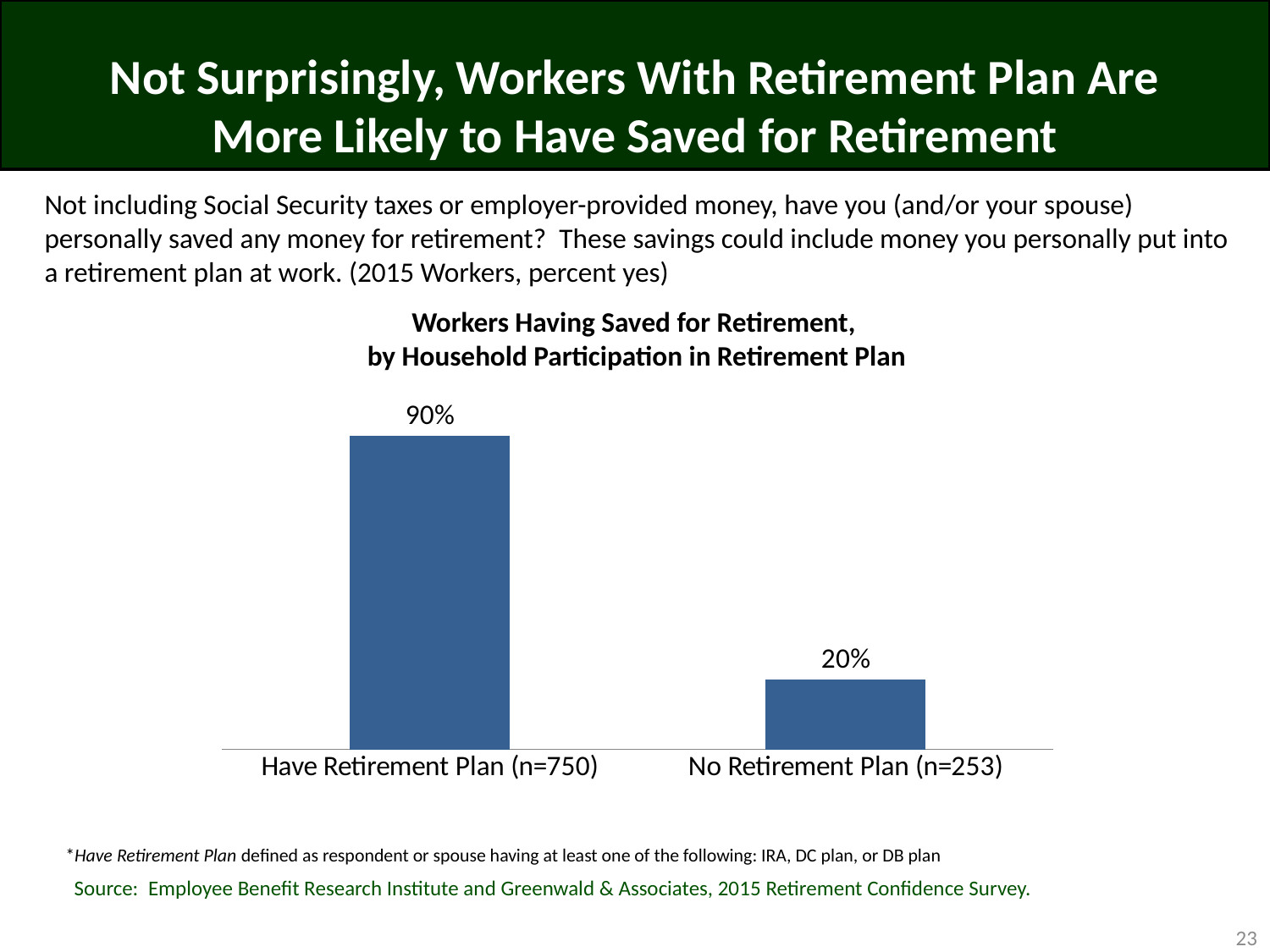
Which category has the higher percentage of workers having saved for retirement? Have Retirement Plan (n=750) Which category has the lowest percentage of workers having saved for retirement? No Retirement Plan (n=253) What is the sample size (n) for the Have Retirement Plan category? 750 What type of chart is shown on the slide? bar chart What percentage of workers with no retirement plan have saved for retirement? 20% What is the title of the chart? Workers Having Saved for Retirement, by Household Participation in Retirement Plan What is the difference in percentage points between workers with a retirement plan and those without who have saved for retirement? 70 Is the value for workers with a retirement plan larger or smaller than the value for workers with no retirement plan? larger How many categories are shown in the chart? 2 What percentage of workers who have a retirement plan have saved for retirement? 90%